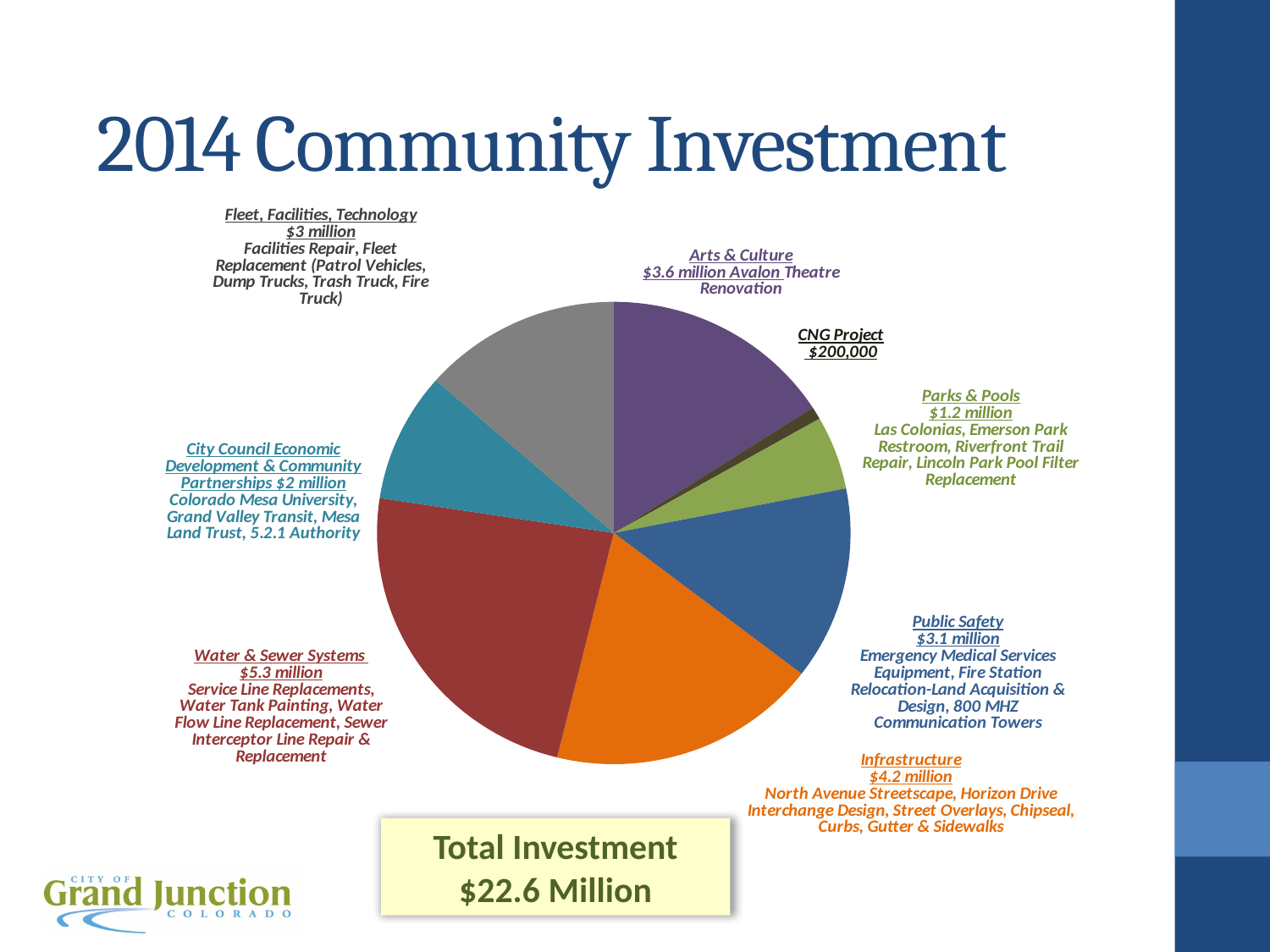
Which category has the smallest investment? CNG Project What is the investment amount for Water & Sewer Systems? $5.3 million What is the investment amount for Parks & Pools? $1.2 million What total investment is stated on the slide? $22.6 Million What is the investment amount for the CNG Project? $200,000 What kind of chart is shown on the slide? Pie chart What is the difference between the Water & Sewer Systems investment and the Infrastructure investment? $1.1 million Which is larger, the investment for Arts & Culture or for Public Safety? Arts & Culture What is the investment amount for Infrastructure? $4.2 million How many categories (slices) does the pie chart have? 8 What is the difference between the Arts & Culture investment and the Fleet, Facilities, Technology investment? $0.6 million Which category has the largest investment? Water & Sewer Systems